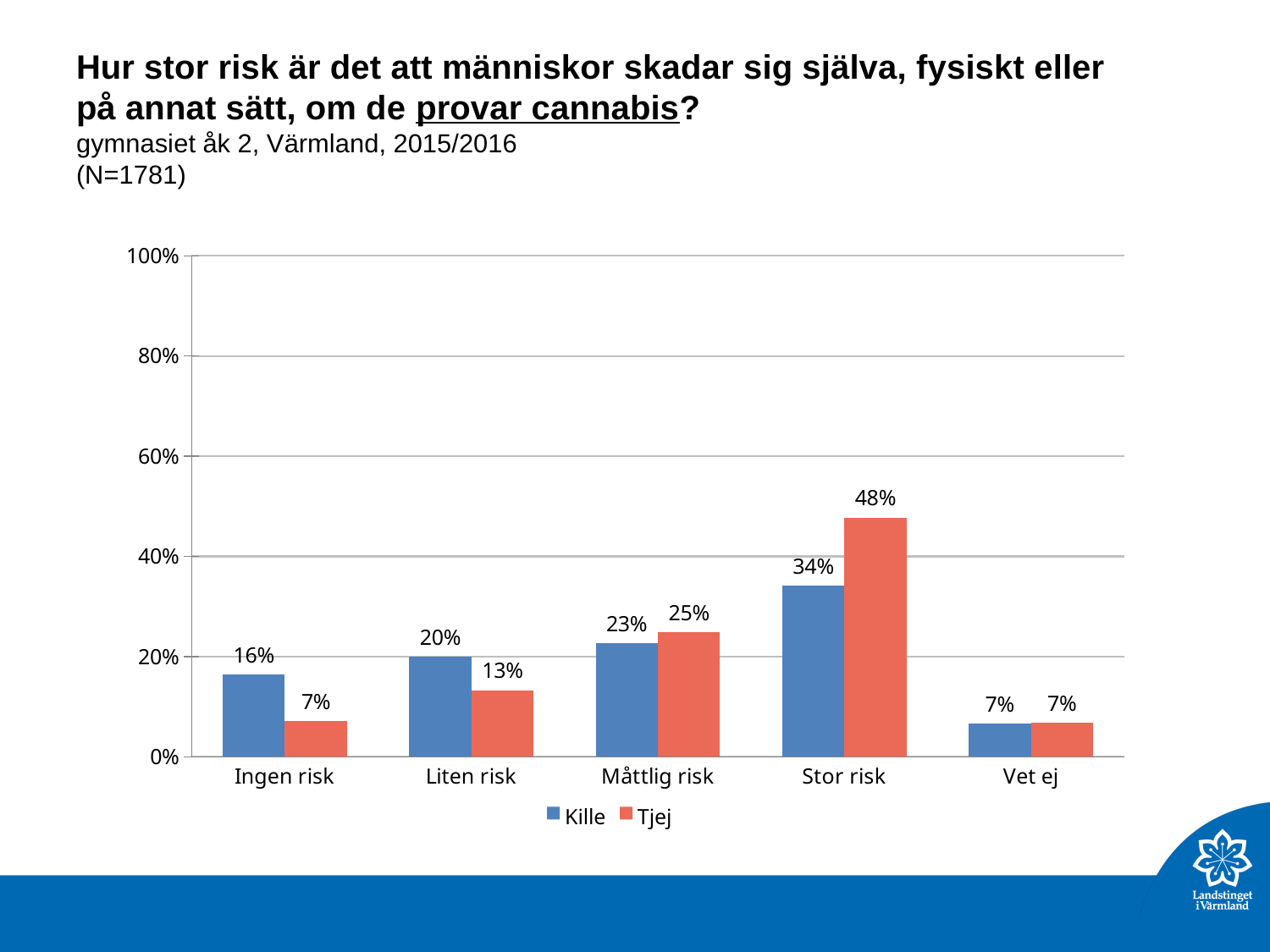
What colour are the bars for the Tjej series? red What kind of chart is shown on the slide? bar chart What is the value for Tjej in the Ingen risk category? 7% What is the value for Kille in the Stor risk category? 34% Which category has the lowest value for Kille? Vet ej What is the value for Tjej in the Liten risk category? 13% Which category has the highest value for Tjej? Stor risk How many categories are shown on the x axis? 5 How many series does the legend list? 2 What is the difference between the Tjej and Kille values in the Stor risk category? 14% In the Liten risk category, which series has the larger value, Kille or Tjej? Kille Is the value for Tjej in the Stor risk category greater or less than 40%? greater